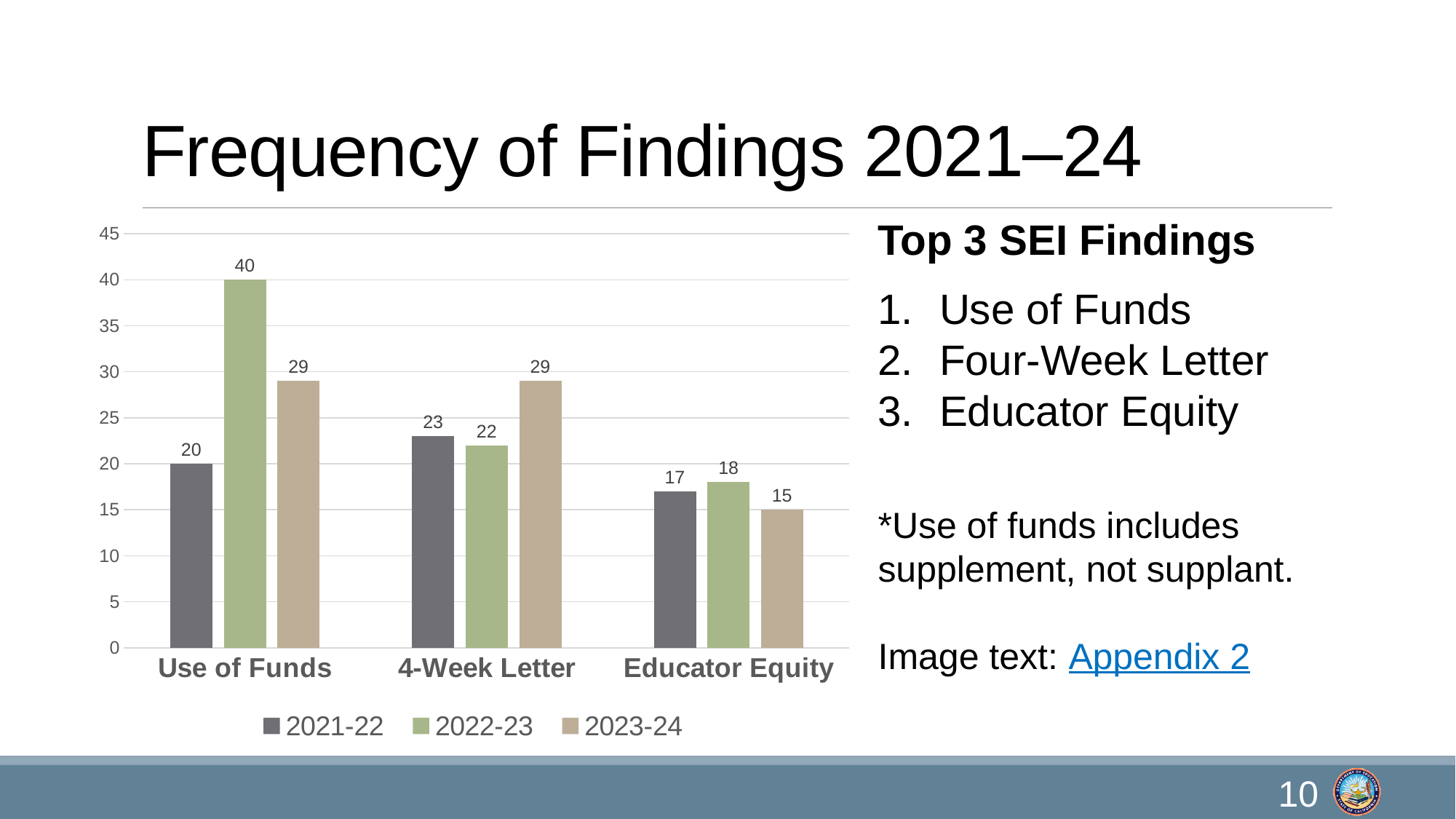
How many series does the legend list? 3 Which is larger for 4-Week Letter: the 2021-22 value or the 2023-24 value? 2023-24 What is the value for Educator Equity in 2023-24? 15 How many categories are shown on the x axis? 3 What is the value for 4-Week Letter in 2021-22? 23 What is the difference between the 2022-23 and 2021-22 values for Use of Funds? 20 What is the value for Use of Funds in 2022-23? 40 What kind of chart is shown on the slide? Bar chart What is the title of the slide containing the chart? Frequency of Findings 2021–24 Which category has the lowest value in 2023-24? Educator Equity Which category has the highest value in 2022-23? Use of Funds